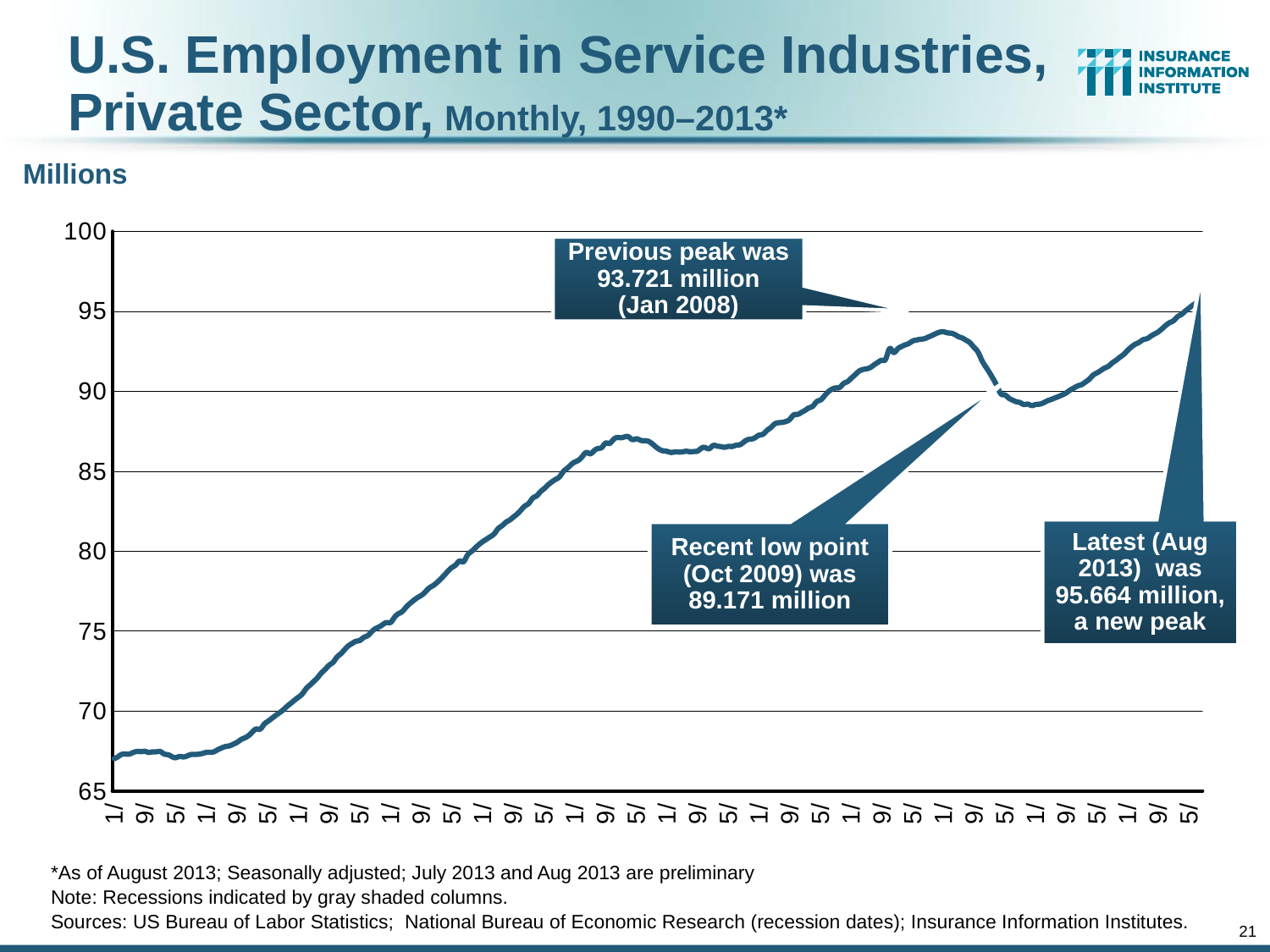
Of the three annotated points (Jan 2008, Oct 2009, Aug 2013), which has the highest value? Aug 2013 In what unit are the values on the vertical axis expressed? Millions What was the latest value, for Aug 2013? 95.664 million What kind of chart is shown on the slide? line chart What was the recent low point value in Oct 2009? 89.171 million Which is larger, the Jan 2008 value or the Aug 2013 value? Aug 2013 What was the previous peak value of U.S. private-sector service employment, reached in Jan 2008? 93.721 million Is the value at the start of the series in 1990 greater or less than 70? less Over the full period from 1990 to 2013, does the plotted employment generally rise or fall? rise By how much does the Aug 2013 value exceed the Jan 2008 previous peak? 1.943 million Of the three annotated points (Jan 2008, Oct 2009, Aug 2013), which has the lowest value? Oct 2009 What is the difference between the Jan 2008 peak and the Oct 2009 low point? 4.550 million